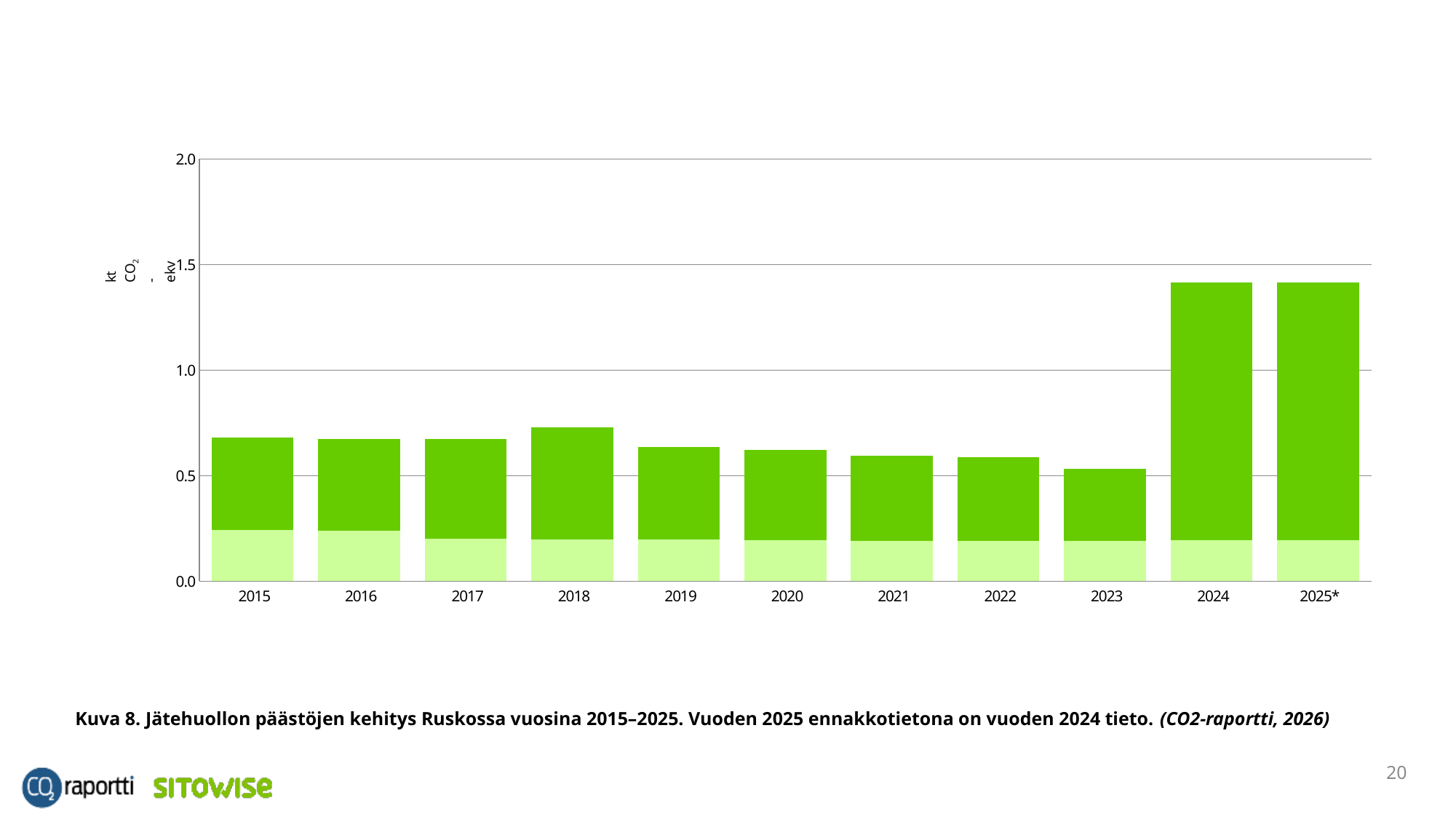
Do the total bar values rise or fall from 2018 to 2023? fall What unit is shown on the y axis of the chart? kt CO2-ekv Which year has the larger total bar, 2018 or 2019? 2018 Which year has the lowest total bar in the chart? 2023 Is the total value for 2015 greater or less than 0.5? greater Which year has the larger total bar, 2023 or 2024? 2024 How many stacked segments (colours) does each bar have? 2 What kind of chart is shown on the slide? Stacked bar chart Is the total value for 2018 greater or less than 1.0? less Is the total value for 2025* greater or less than 1.5? less How many years (bars) are shown on the x axis of the chart? 11